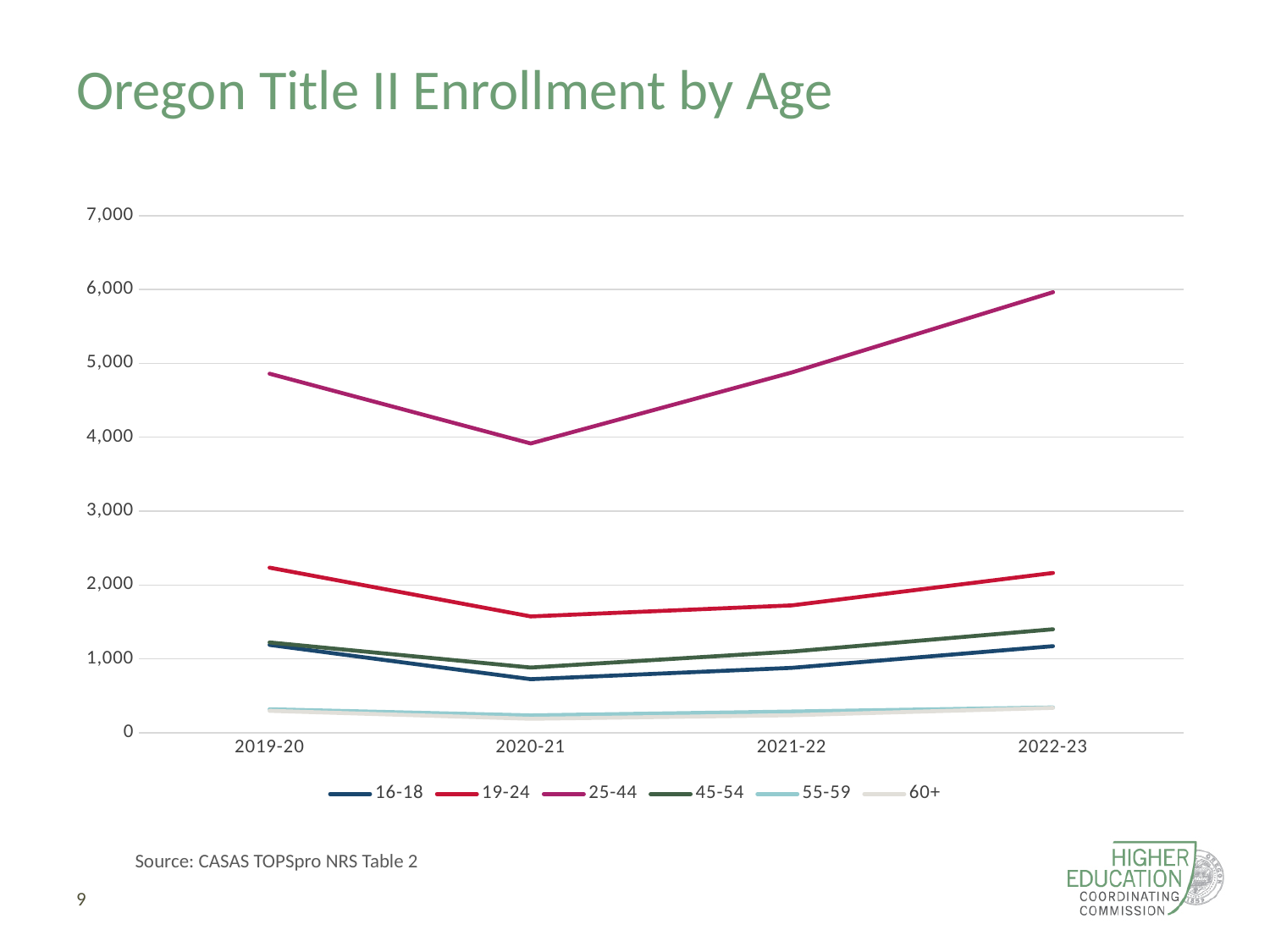
What kind of chart is shown on the slide? line chart Which age group has the highest enrollment in 2022-23? 25-44 Is the value for the 25-44 age group in 2022-23 greater or less than 5,000? greater How many series does the legend list? 6 How many program years are shown on the x axis? 4 What is the title of the chart? Oregon Title II Enrollment by Age Which is larger in 2022-23, the value for 19-24 or the value for 45-54? 19-24 Is the value for the 16-18 age group in 2020-21 greater or less than 1,000? less Is the value for the 19-24 age group in 2020-21 greater or less than 2,000? less In which year is enrollment for the 25-44 age group lowest? 2020-21 Does enrollment for the 25-44 age group rise or fall from 2020-21 to 2022-23? rise In which year is enrollment for the 25-44 age group highest? 2022-23